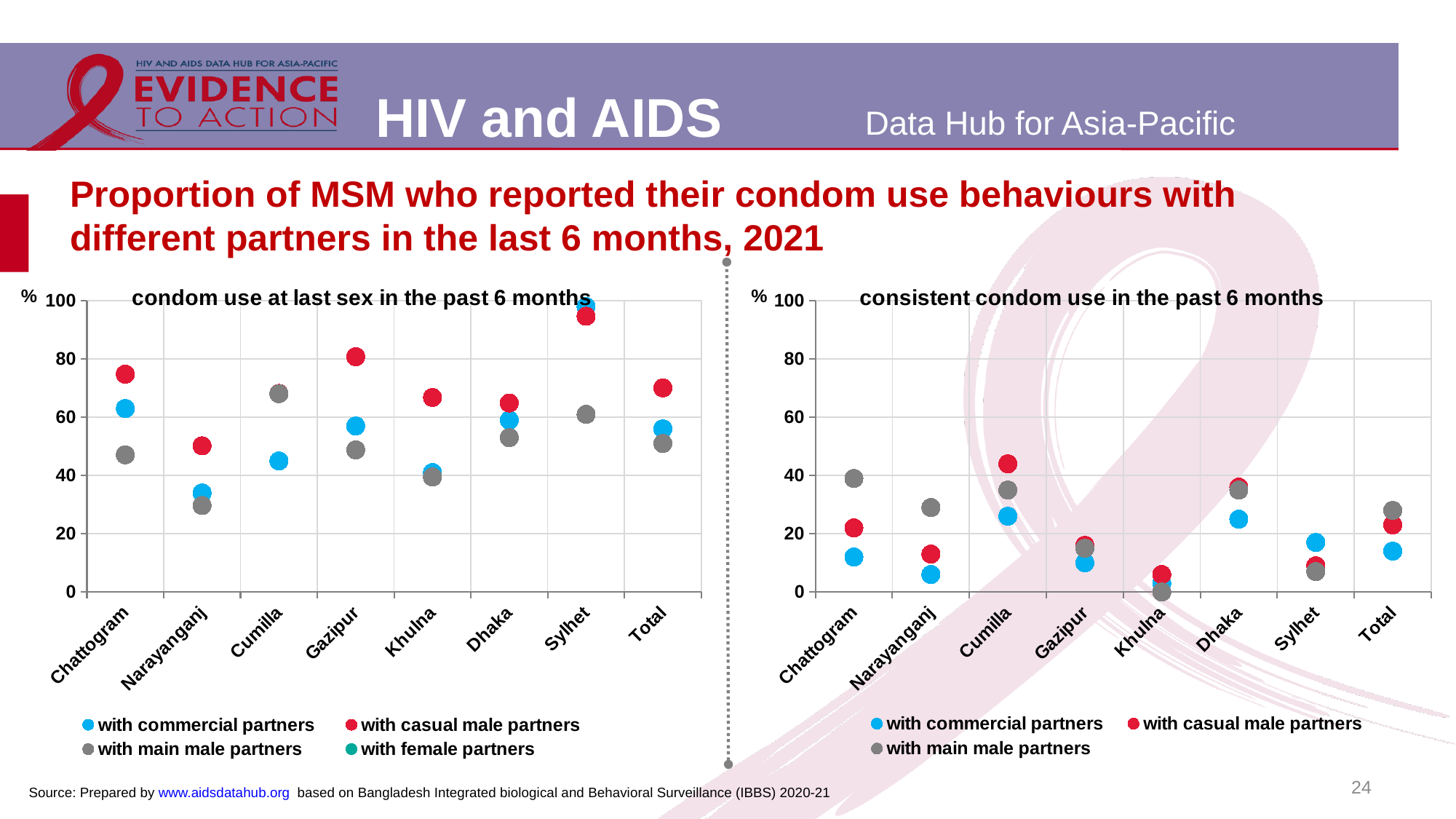
In the left chart (condom use at last sex in the past 6 months), for Chattogram, which is larger: the value with casual male partners or with main male partners? with casual male partners How many series does the legend of the left chart (condom use at last sex in the past 6 months) list? 4 What kind of chart is the left chart titled 'condom use at last sex in the past 6 months'? scatter chart In the right chart (consistent condom use in the past 6 months), is the value for Khulna with commercial partners greater or less than 20? less How many series does the legend of the right chart (consistent condom use in the past 6 months) list? 3 In the right chart (consistent condom use in the past 6 months), for Chattogram, which is larger: the value with main male partners or with commercial partners? with main male partners In the left chart (condom use at last sex in the past 6 months), is the value for Chattogram with casual male partners greater or less than 60? greater In the left chart (condom use at last sex in the past 6 months), how many categories are shown on the x axis? 8 What is the title of the right chart on the slide? consistent condom use in the past 6 months In the right chart (consistent condom use in the past 6 months), which category has the highest value for with casual male partners? Cumilla In the right chart (consistent condom use in the past 6 months), which category has the lowest value for with main male partners? Khulna In the left chart (condom use at last sex in the past 6 months), which category has the highest value for with commercial partners? Sylhet